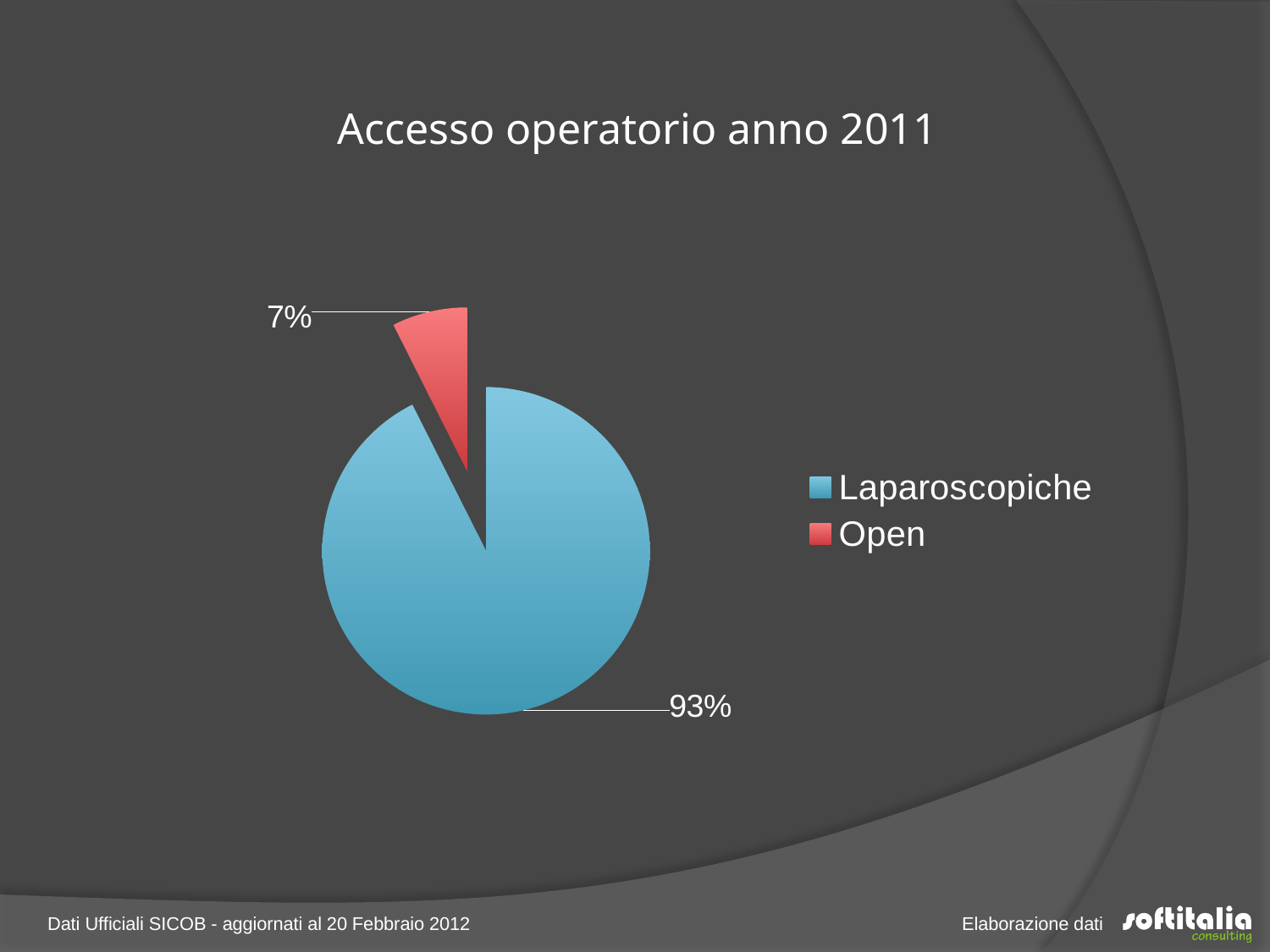
What is the title of the chart? Accesso operatorio anno 2011 What percentage of the pie is Laparoscopiche? 93% What percentage of the pie is Open? 7% What kind of chart is shown on the slide? pie chart How many slices does the pie chart have? 2 Which is larger, the share for Laparoscopiche or the share for Open? Laparoscopiche Which category has the smallest share of the pie? Open Which category has the largest share of the pie? Laparoscopiche How many entries does the legend list? 2 What is the share of the pie for the Laparoscopiche slice? 93% What colour is the Open slice? red What is the difference in percentage points between Laparoscopiche and Open? 86